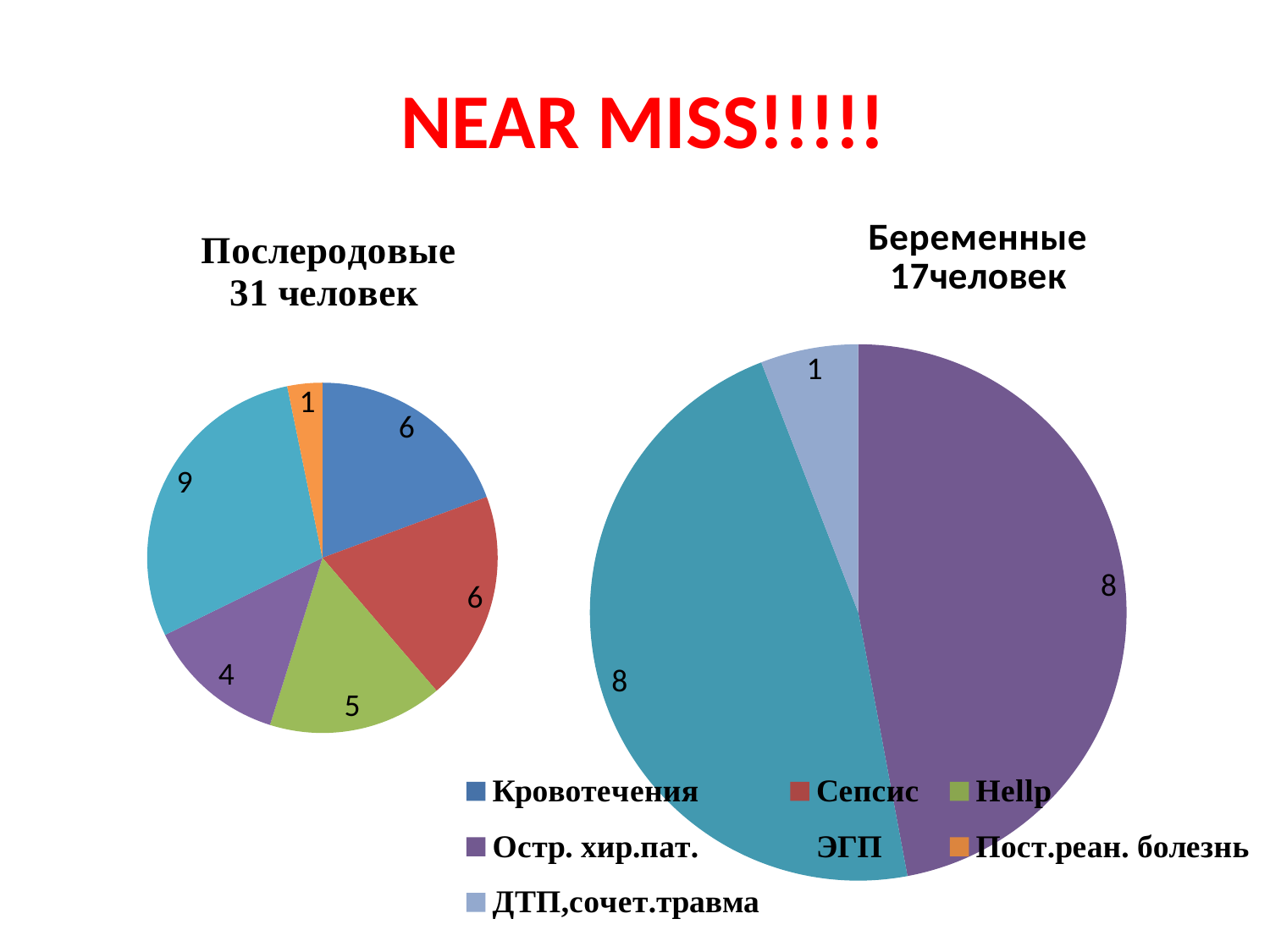
In the pie chart titled "Послеродовые 31 человек", which category has the smallest slice? Пост.реан. болезнь In the pie chart titled "Беременные 17человек", which category has the smallest slice? ДТП,сочет.травма In the pie chart titled "Беременные 17человек", what is the difference between the values for ЭГП and ДТП,сочет.травма? 7 In the pie chart titled "Послеродовые 31 человек", what is the difference between the values for ЭГП and Остр. хир.пат.? 5 In the pie chart titled "Беременные 17человек", what is the value for Остр. хир.пат.? 8 What type of chart is used for "Послеродовые 31 человек"? Pie chart In the pie chart titled "Беременные 17человек", what is the value for ДТП,сочет.травма? 1 In the pie chart titled "Послеродовые 31 человек", which category has the largest slice? ЭГП In the pie chart titled "Послеродовые 31 человек", what is the value for Hellp? 5 How many slices does the pie chart titled "Беременные 17человек" have? 3 In the pie chart titled "Послеродовые 31 человек", which is larger: Hellp or Остр. хир.пат.? Hellp In the pie chart titled "Послеродовые 31 человек", what is the value for ЭГП? 9